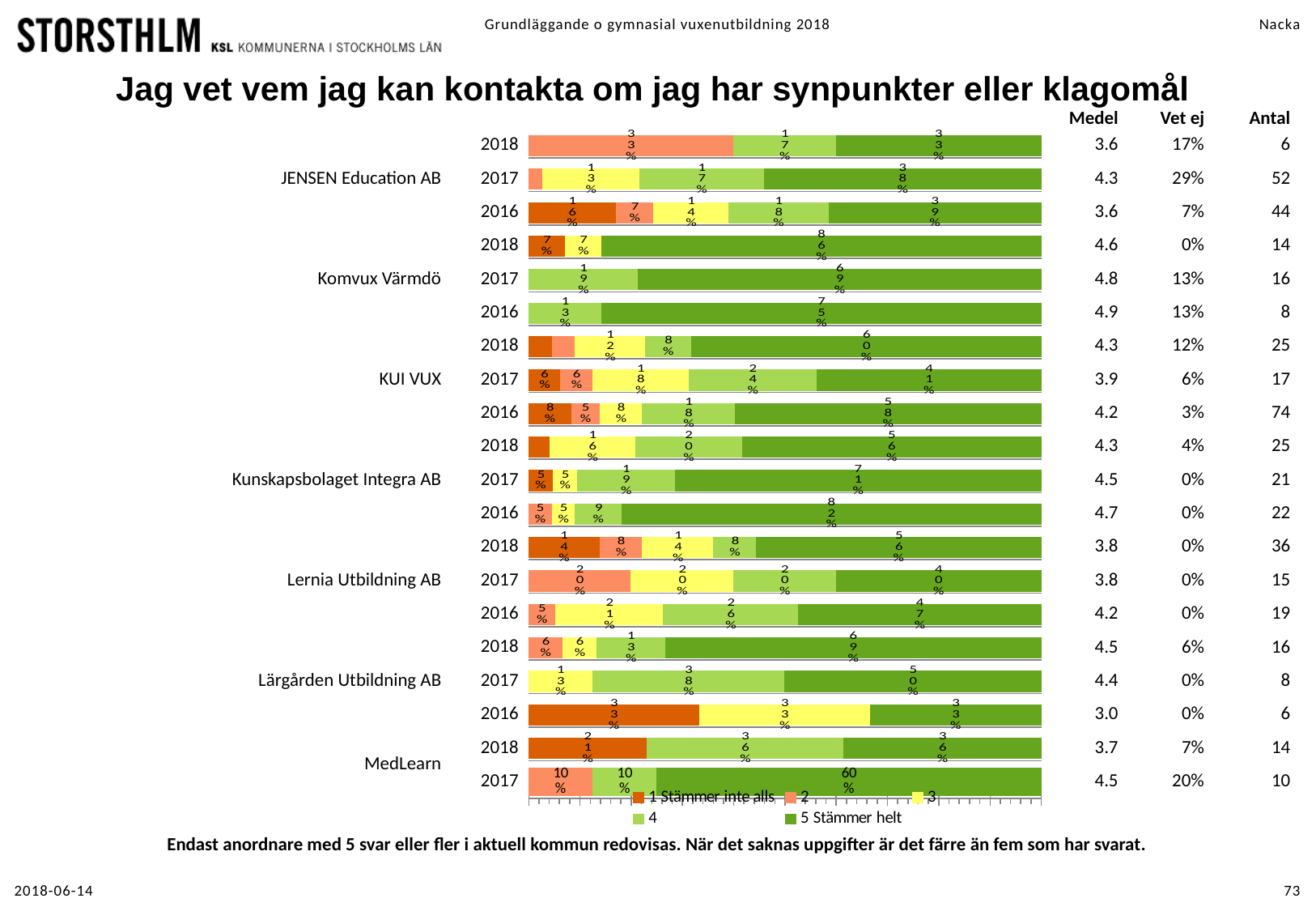
For Lernia Utbildning AB in 2017, what is the difference between the '5 Stämmer helt' segment and the '3' segment? 20 percentage points For Komvux Värmdö, which year has the larger '5 Stämmer helt' share, 2017 or 2016? 2016 What is the title of the chart? Jag vet vem jag kan kontakta om jag har synpunkter eller klagomål What is the value of the '5 Stämmer helt' segment for Lernia Utbildning AB in 2017? 40% What is the value of the '4' segment for Komvux Värmdö in 2017? 19% What kind of chart is shown on the slide? Stacked bar chart What is the first entry in the chart legend? 1 Stämmer inte alls What is the value of the '5 Stämmer helt' segment for MedLearn in 2017? 60% What is the value of the '1 Stämmer inte alls' segment for Lärgården Utbildning AB in 2016? 33% How many series does the chart legend list? 5 How many education providers are listed on the chart? 7 What is the value of the '5 Stämmer helt' segment for Komvux Värmdö in 2018? 86%